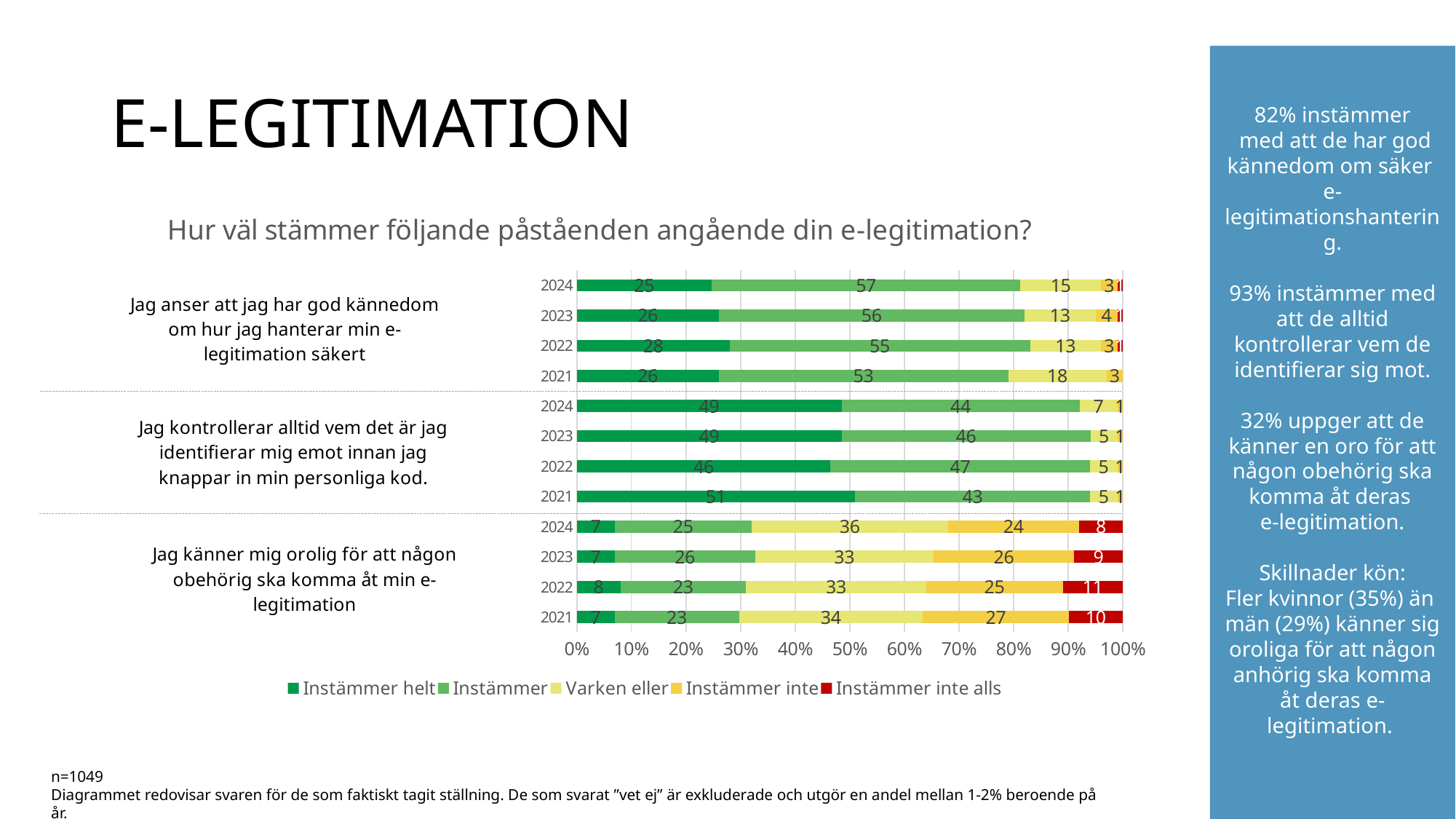
What is the 'Varken eller' value for 'Jag anser att jag har god kännedom om hur jag hanterar min e-legitimation säkert' in 2021? 18 What kind of chart is shown on the slide? Stacked bar chart How many years are shown for each statement in the chart? 4 For 'Jag kontrollerar alltid vem det är jag identifierar mig emot innan jag knappar in min personliga kod.', which year has the larger 'Instämmer helt' value, 2021 or 2022? 2021 For 'Jag anser att jag har god kännedom om hur jag hanterar min e-legitimation säkert', which year has the highest 'Varken eller' value? 2021 How many series does the legend list? 5 For 'Jag känner mig orolig för att någon obehörig ska komma åt min e-legitimation', which year has the highest 'Instämmer inte alls' value? 2022 What is the combined value of 'Instämmer helt' and 'Instämmer' for 'Jag kontrollerar alltid vem det är jag identifierar mig emot innan jag knappar in min personliga kod.' in 2024? 93 What is the 'Instämmer inte alls' value for 'Jag känner mig orolig för att någon obehörig ska komma åt min e-legitimation' in 2022? 11 What is the 'Instämmer helt' value for 'Jag kontrollerar alltid vem det är jag identifierar mig emot innan jag knappar in min personliga kod.' in 2024? 49 What is the 'Instämmer inte' value for 'Jag känner mig orolig för att någon obehörig ska komma åt min e-legitimation' in 2021? 27 What is the difference between the 'Instämmer' values for 'Jag anser att jag har god kännedom om hur jag hanterar min e-legitimation säkert' in 2024 and 2021? 4